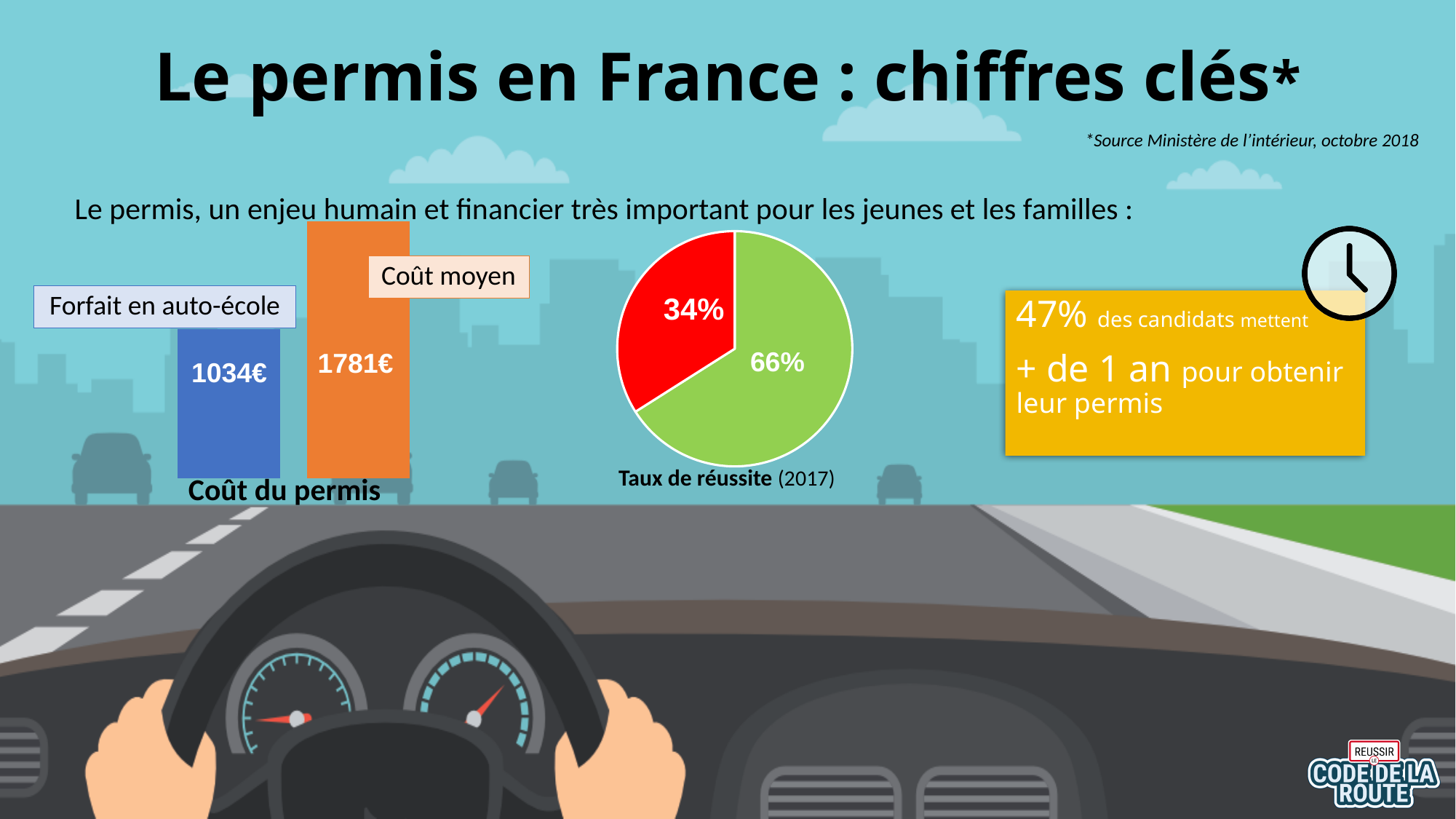
In the 'Taux de réussite (2017)' pie chart, what share does the red slice represent? 34% In the 'Taux de réussite (2017)' pie chart, what share does the green slice represent? 66% What kind of chart is the 'Taux de réussite (2017)' chart? Pie chart In the 'Coût du permis' chart, what is the value for 'Forfait en auto-école'? 1034€ In the 'Coût du permis' chart, what is the value for 'Coût moyen'? 1781€ In the 'Coût du permis' chart, which is larger: 'Forfait en auto-école' or 'Coût moyen'? Coût moyen How many slices does the 'Taux de réussite (2017)' pie chart have? 2 In the 'Coût du permis' chart, what is the difference between 'Coût moyen' and 'Forfait en auto-école'? 747€ In the 'Coût du permis' chart, which category has the highest value? Coût moyen How many bars are shown in the 'Coût du permis' chart? 2 What kind of chart is the 'Coût du permis' chart? Bar chart In the 'Coût du permis' chart, which category has the lowest value? Forfait en auto-école